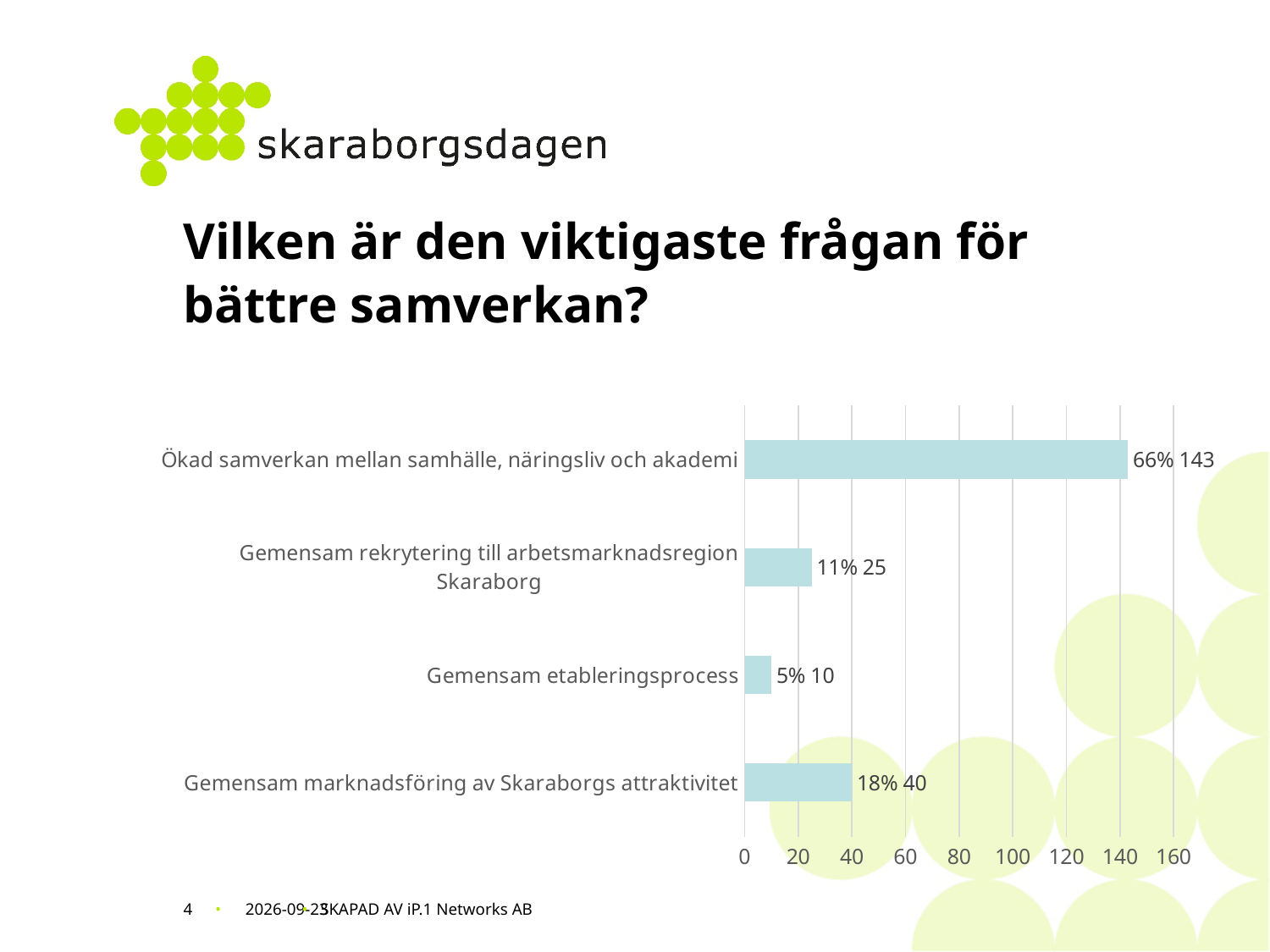
Which category has the highest value? Ökad samverkan mellan samhälle, näringsliv och akademi Which is larger: the value for "Gemensam rekrytering till arbetsmarknadsregion Skaraborg" or "Gemensam marknadsföring av Skaraborgs attraktivitet"? Gemensam marknadsföring av Skaraborgs attraktivitet What kind of chart is shown on the slide? Bar chart What is the title of the slide containing the chart? Vilken är den viktigaste frågan för bättre samverkan? What is the value for "Ökad samverkan mellan samhälle, näringsliv och akademi"? 143 Is the value for "Ökad samverkan mellan samhälle, näringsliv och akademi" greater or less than 120? greater What percentage is shown for "Gemensam rekrytering till arbetsmarknadsregion Skaraborg"? 11% Which category has the lowest value? Gemensam etableringsprocess What is the difference between the values for "Ökad samverkan mellan samhälle, näringsliv och akademi" and "Gemensam marknadsföring av Skaraborgs attraktivitet"? 103 How many categories are shown in the chart? 4 What is the value for "Gemensam etableringsprocess"? 10 What percentage is shown for "Gemensam marknadsföring av Skaraborgs attraktivitet"? 18%